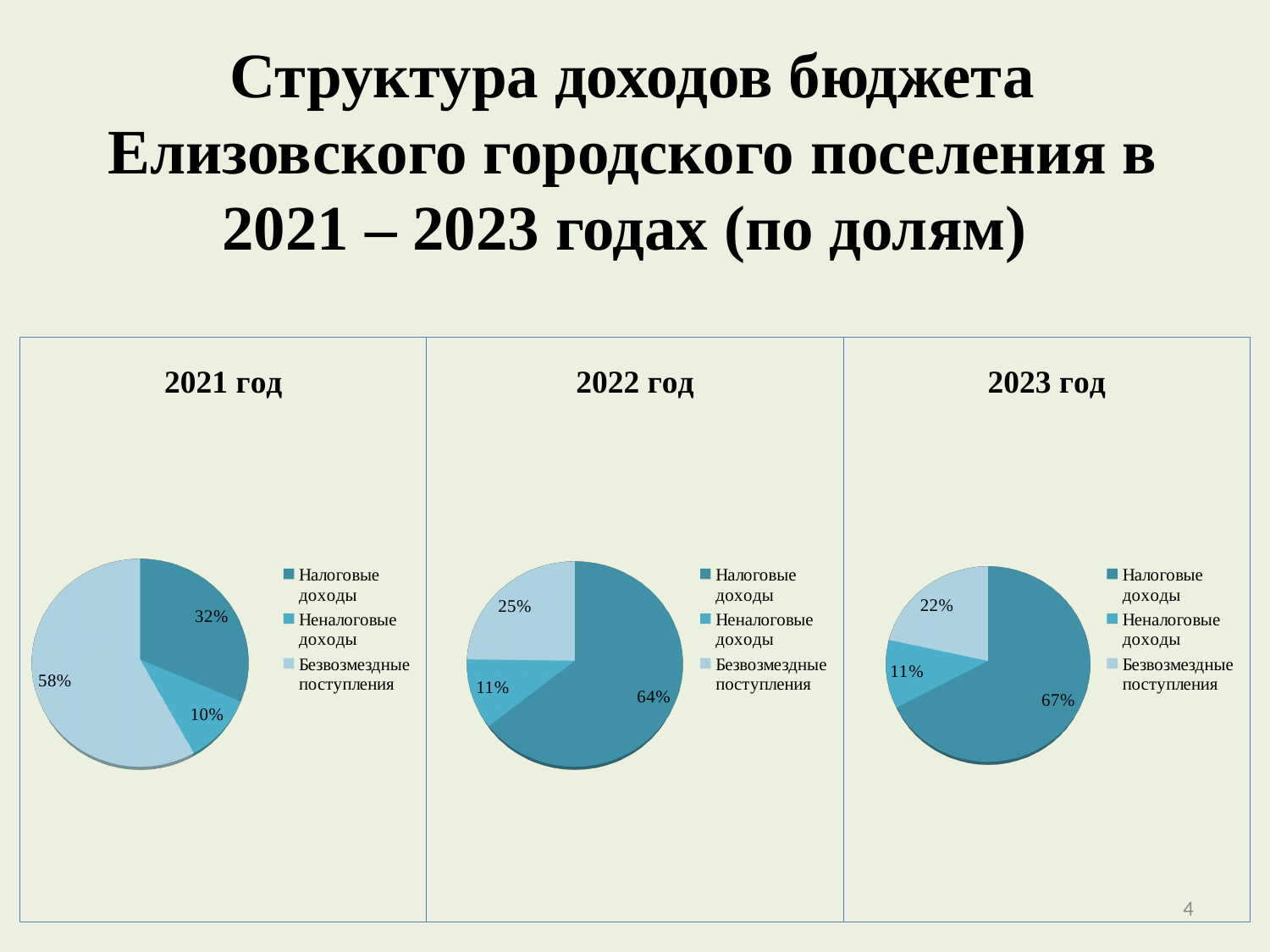
In the 2023 год chart, which is larger: Налоговые доходы or Безвозмездные поступления? Налоговые доходы In the 2022 год chart, what share is Налоговые доходы? 64% In the 2022 год chart, what is the difference between Налоговые доходы and Безвозмездные поступления? 39% In the 2021 год chart, what share is Безвозмездные поступления? 58% In the 2021 год chart, what share is Налоговые доходы? 32% How many entries does the legend of the 2023 год chart list? 3 How many slices does the 2022 год chart have? 3 In the 2023 год chart, which category has the smallest slice? Неналоговые доходы In the 2021 год chart, what share is Неналоговые доходы? 10% In the 2021 год chart, which category has the largest slice? Безвозмездные поступления What kind of chart is the 2021 год chart? Pie chart In the 2023 год chart, what share is Безвозмездные поступления? 22%